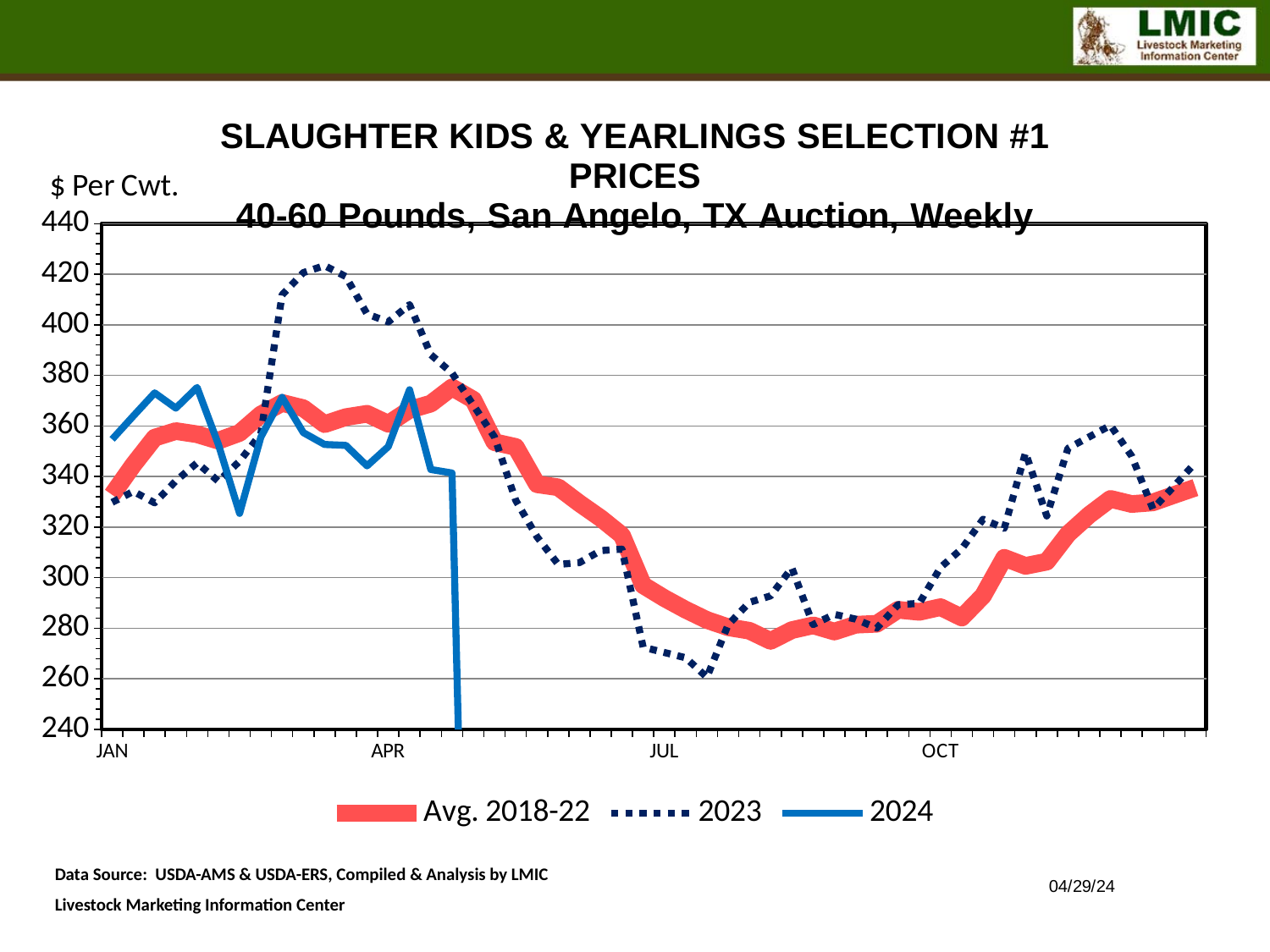
Is the value of the Avg. 2018-22 series at the start of January greater or less than 320? greater Is the highest value of the 2024 series in February greater or less than 360? greater Which series reaches the highest value anywhere on the chart? 2023 What unit is shown on the y axis of the chart? $ Per Cwt. Is the lowest value of the 2023 series in August greater or less than 280? less How many month labels are shown on the x axis? 4 What kind of chart is shown on the slide? line chart Does the Avg. 2018-22 series rise or fall between April and August? fall In late March, which is higher: the 2023 series or the Avg. 2018-22 series? 2023 Which series is drawn as a dotted line in the chart? 2023 How many series does the legend list? 3